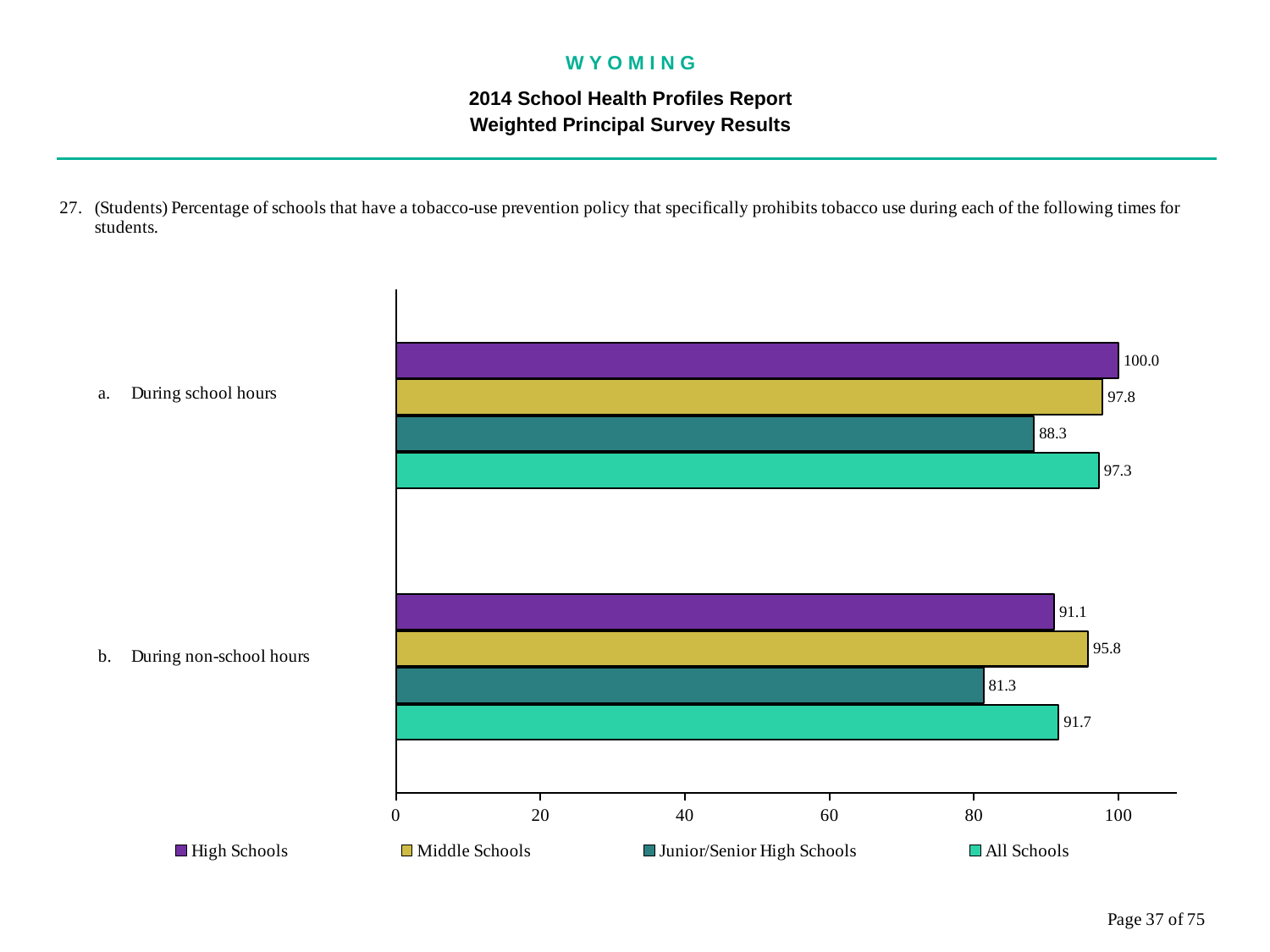
What is the value for Junior/Senior High Schools during non-school hours? 81.3 Which school type has the lowest value during school hours? Junior/Senior High Schools Which is larger: the Middle Schools value during school hours or the All Schools value during school hours? Middle Schools during school hours How many series does the legend list? 4 How many categories (time periods) are shown on the chart? 2 Is the value for Junior/Senior High Schools during non-school hours greater or less than 80? greater What is the difference between the High Schools values during school hours and during non-school hours? 8.9 What is the value for Middle Schools during non-school hours? 95.8 What kind of chart is shown on the slide? Bar chart Which school type has the highest value during non-school hours? Middle Schools What is the value for High Schools during school hours? 100.0 What is the value for All Schools during school hours? 97.3